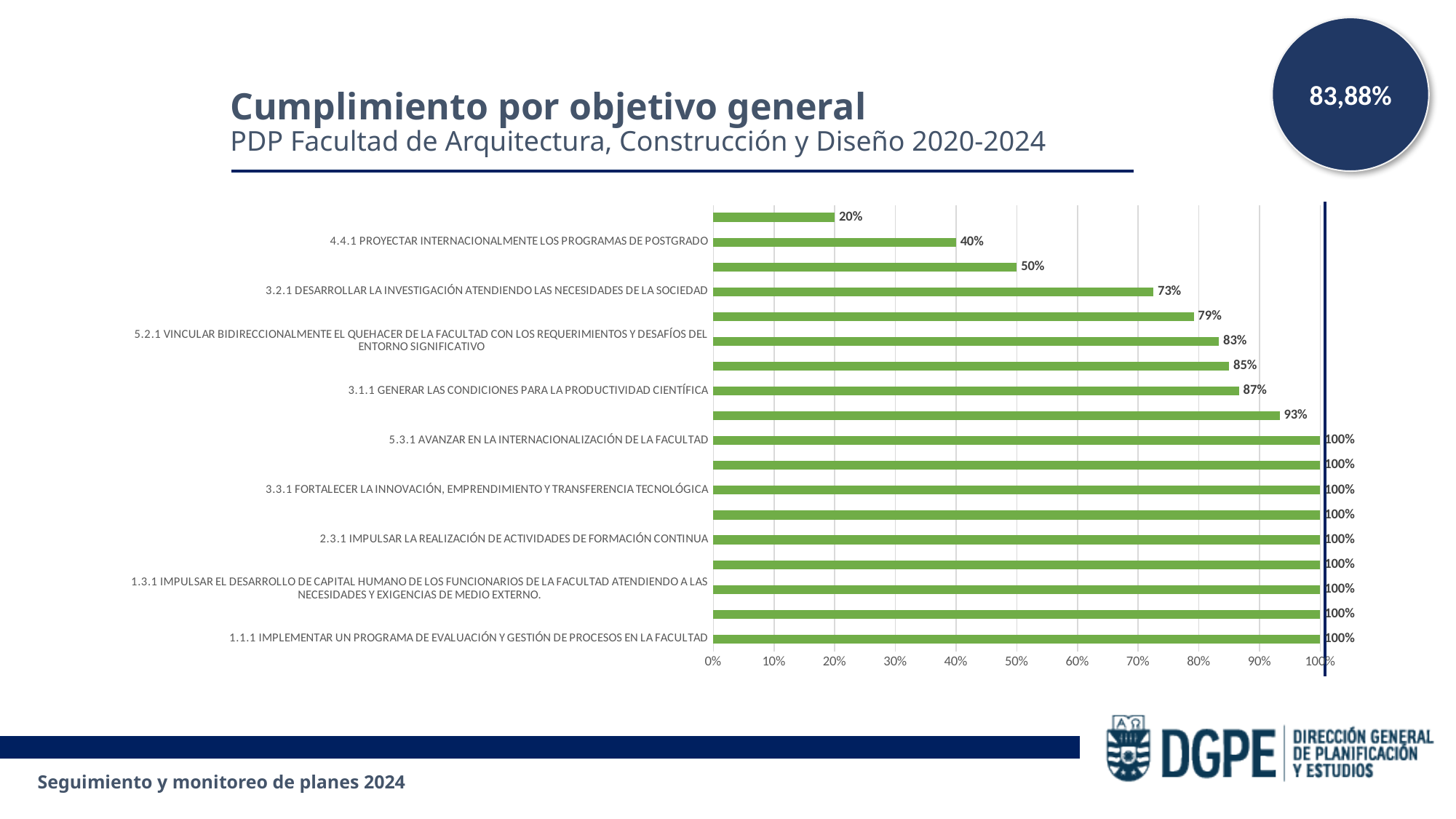
What is the value for 3.1.1 GENERAR LAS CONDICIONES PARA LA PRODUCTIVIDAD CIENTÍFICA? 87% What is the difference between the values for 3.1.1 GENERAR LAS CONDICIONES PARA LA PRODUCTIVIDAD CIENTÍFICA and 3.2.1 DESARROLLAR LA INVESTIGACIÓN ATENDIENDO LAS NECESIDADES DE LA SOCIEDAD? 14% How many bars are plotted in the chart? 18 Is the value for 3.2.1 DESARROLLAR LA INVESTIGACIÓN ATENDIENDO LAS NECESIDADES DE LA SOCIEDAD greater or less than 60%? greater Which has a larger value: 4.4.1 PROYECTAR INTERNACIONALMENTE LOS PROGRAMAS DE POSTGRADO or 5.2.1 VINCULAR BIDIRECCIONALMENTE EL QUEHACER DE LA FACULTAD CON LOS REQUERIMIENTOS Y DESAFÍOS DEL ENTORNO SIGNIFICATIVO? 5.2.1 VINCULAR BIDIRECCIONALMENTE EL QUEHACER DE LA FACULTAD CON LOS REQUERIMIENTOS Y DESAFÍOS DEL ENTORNO SIGNIFICATIVO How many bars in the chart reach 100%? 9 What type of chart is shown on the slide? Bar chart What is the value for 5.2.1 VINCULAR BIDIRECCIONALMENTE EL QUEHACER DE LA FACULTAD CON LOS REQUERIMIENTOS Y DESAFÍOS DEL ENTORNO SIGNIFICATIVO? 83% What is the value for 3.2.1 DESARROLLAR LA INVESTIGACIÓN ATENDIENDO LAS NECESIDADES DE LA SOCIEDAD? 73% What is the value for 1.1.1 IMPLEMENTAR UN PROGRAMA DE EVALUACIÓN Y GESTIÓN DE PROCESOS EN LA FACULTAD? 100% What is the smallest value labeled on the chart? 20% What is the value for 4.4.1 PROYECTAR INTERNACIONALMENTE LOS PROGRAMAS DE POSTGRADO? 40%